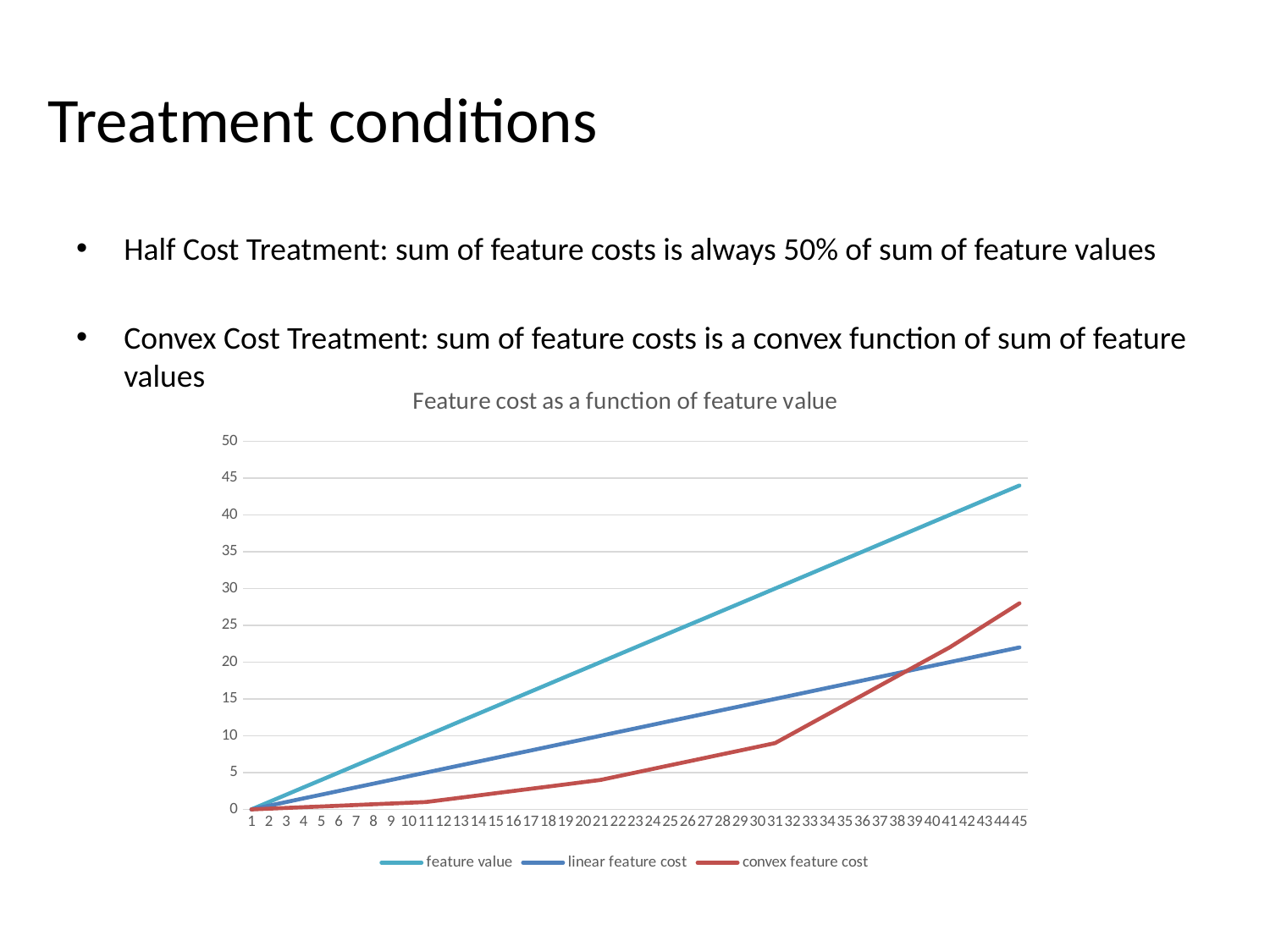
How many points are labelled on the x axis? 45 Which series has the lowest value at x = 45? linear feature cost Is the convex feature cost at x = 45 greater or less than 25? greater How many series does the legend list? 3 Is the feature value at x = 45 greater or less than 40? greater What kind of chart is shown on the slide? line chart At x = 21, which is larger: linear feature cost or convex feature cost? linear feature cost At x = 45, which is larger: convex feature cost or linear feature cost? convex feature cost Is the linear feature cost at x = 45 greater or less than 25? less What is the title of the chart? Feature cost as a function of feature value Does the feature value series rise or fall along the x axis? rise Which series has the highest value at x = 45? feature value